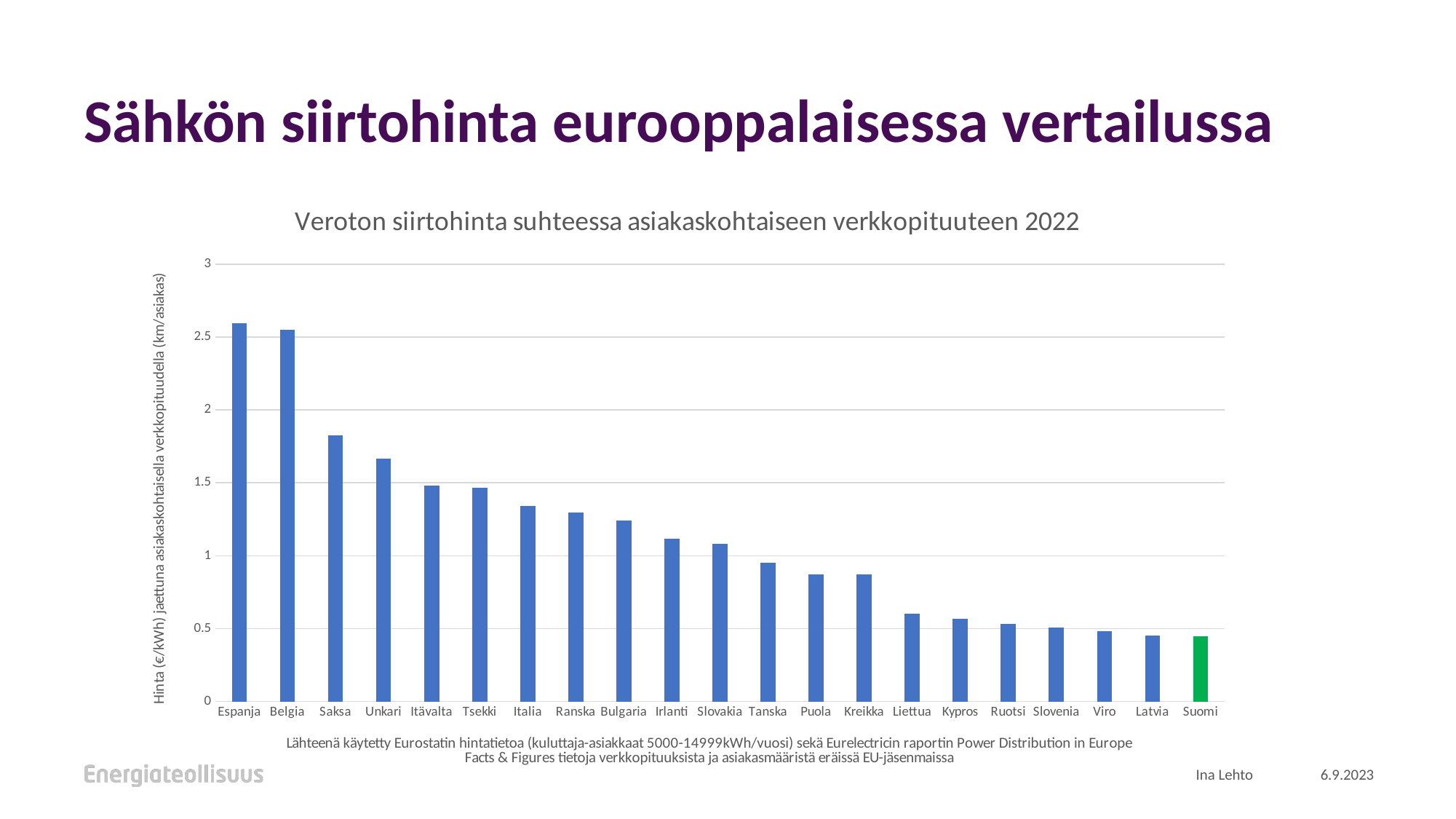
Is the value for Saksa greater or less than 1.5? greater Do the values rise or fall moving from left to right along the x axis? fall How many countries are shown on the x axis of the chart? 21 Is the value for Italia greater or less than 1.5? less Is the value for Liettua greater or less than 0.5? greater Which has the larger value, Saksa or Unkari? Saksa Which has the larger value, Italia or Bulgaria? Italia What kind of chart is shown on the slide? bar chart What is the title of the chart? Veroton siirtohinta suhteessa asiakaskohtaiseen verkkopituuteen 2022 Which country's bar is coloured green instead of blue? Suomi